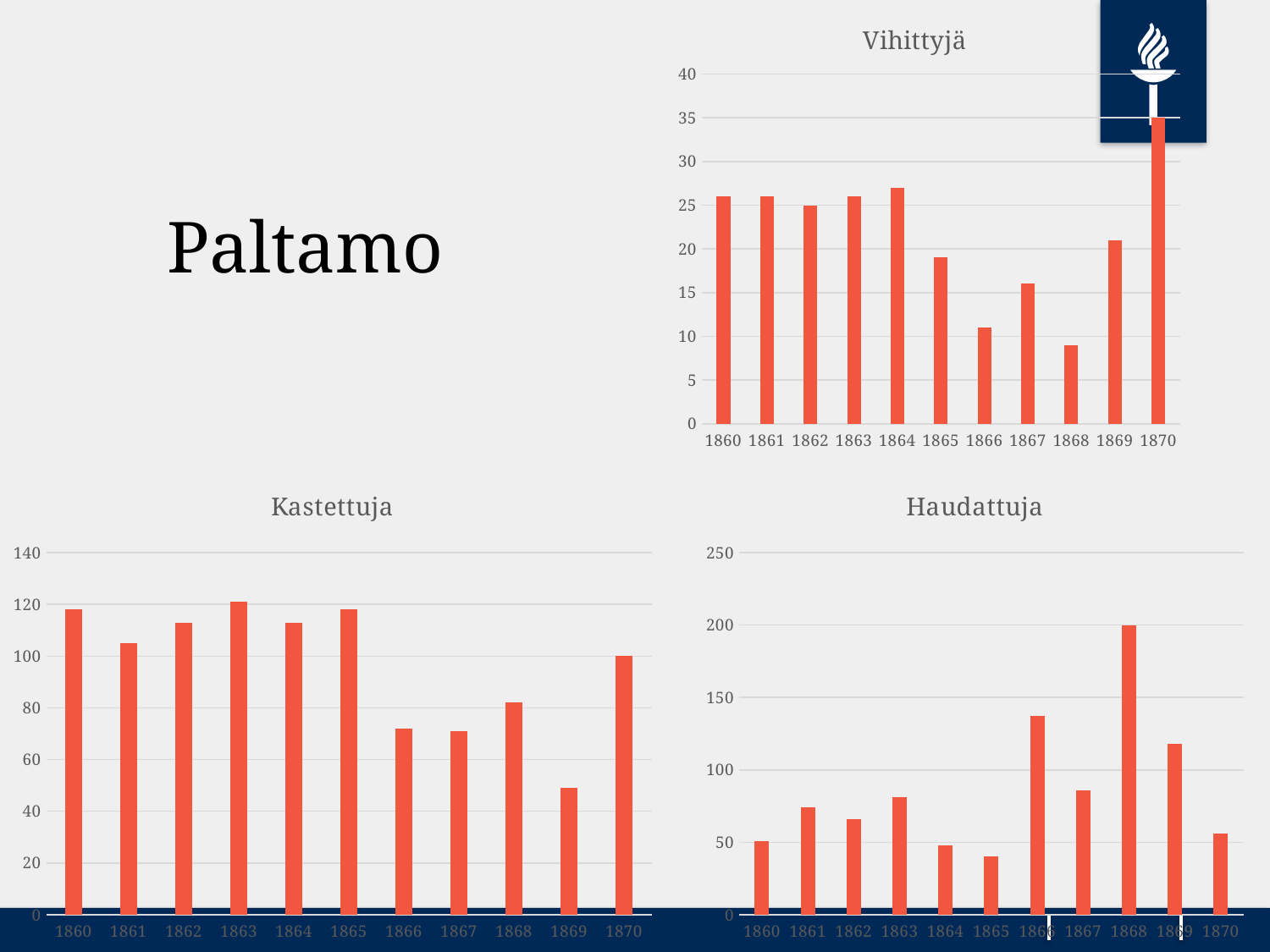
In the 'Kastettuja' chart, what is the value for 1870? 100 In the 'Haudattuja' chart, which year has the highest value? 1868 In the 'Vihittyjä' chart, which is larger, the value for 1864 or the value for 1865? 1864 What type of chart is the 'Vihittyjä' chart? bar chart In the 'Kastettuja' chart, which year has the lowest value? 1869 In the 'Kastettuja' chart, is the value for 1866 greater or less than 80? less In the 'Haudattuja' chart, is the value for 1866 greater or less than 100? greater In the 'Vihittyjä' chart, which year has the highest value? 1870 How many charts are shown on the slide? 3 In the 'Vihittyjä' chart, which year has the lowest value? 1868 In the 'Vihittyjä' chart, what is the value for 1870? 35 How many years are shown on the x axis of the 'Kastettuja' chart? 11